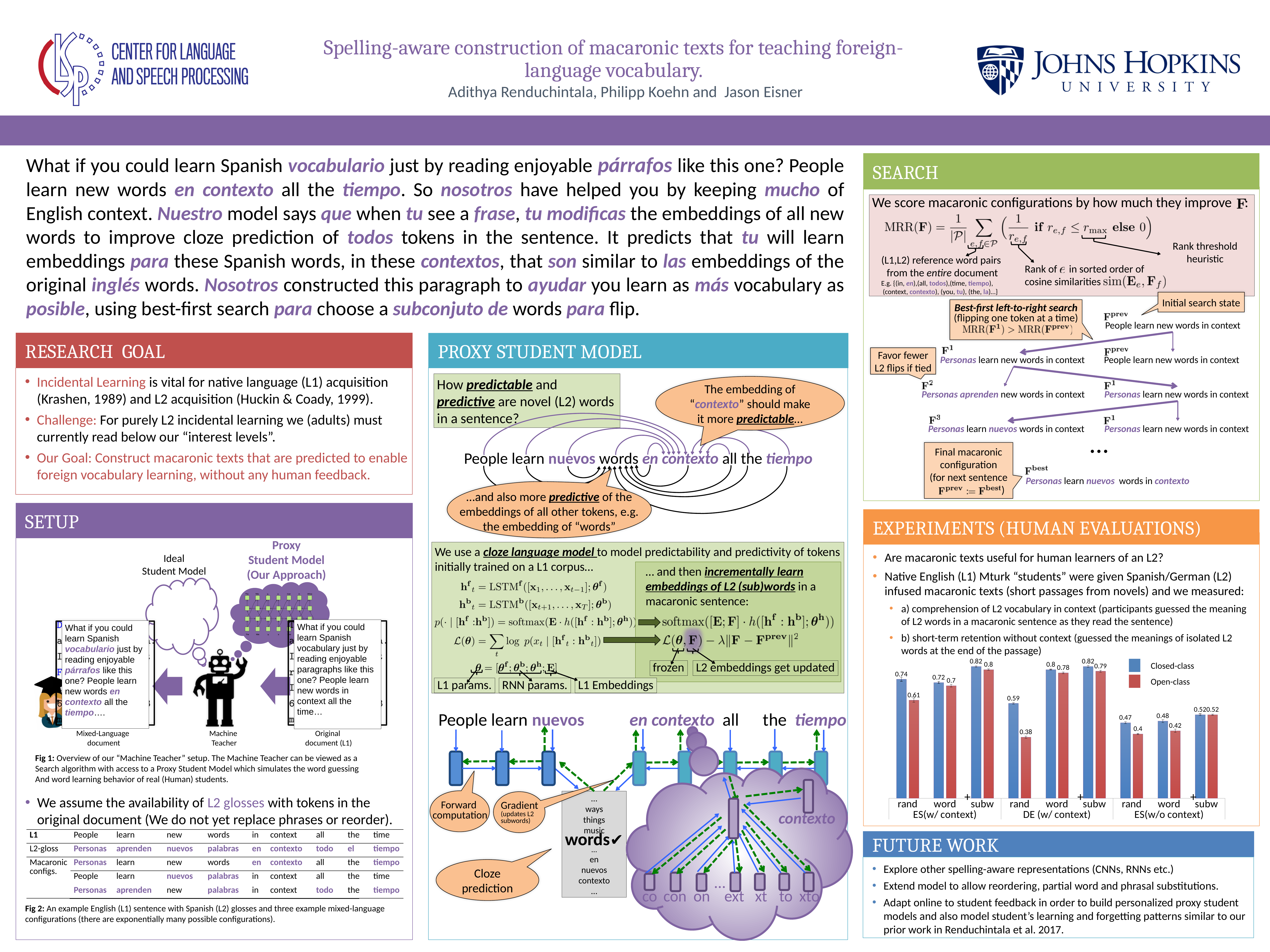
In the Experiments bar chart, what is the difference between the Closed-class and Open-class values for rand under DE (w/ context)? 0.21 In the Experiments bar chart, what is the Closed-class value for rand under ES(w/ context)? 0.74 In the Experiments bar chart, how many category groups (bar pairs) are plotted along the x axis? 9 In the Experiments bar chart, what is the Open-class value for rand under DE (w/ context)? 0.38 In the Experiments bar chart, what is the Open-class value for subw under ES(w/o context)? 0.52 In the Experiments bar chart, what is the Closed-class value for word under DE (w/ context)? 0.8 What kind of chart is shown in the Experiments (Human Evaluations) section? bar chart In the Experiments bar chart, what is the difference between the Closed-class and Open-class values for rand under ES(w/ context)? 0.13 In the Experiments bar chart, which is larger: the Closed-class value for subw under ES(w/ context) or the Closed-class value for rand under ES(w/o context)? subw under ES(w/ context) In the Experiments bar chart, which group has the lowest Open-class value? rand under DE (w/ context) How many series does the legend of the bar chart in the Experiments section list? 2 In the Experiments bar chart, which colour represents the Open-class series? red